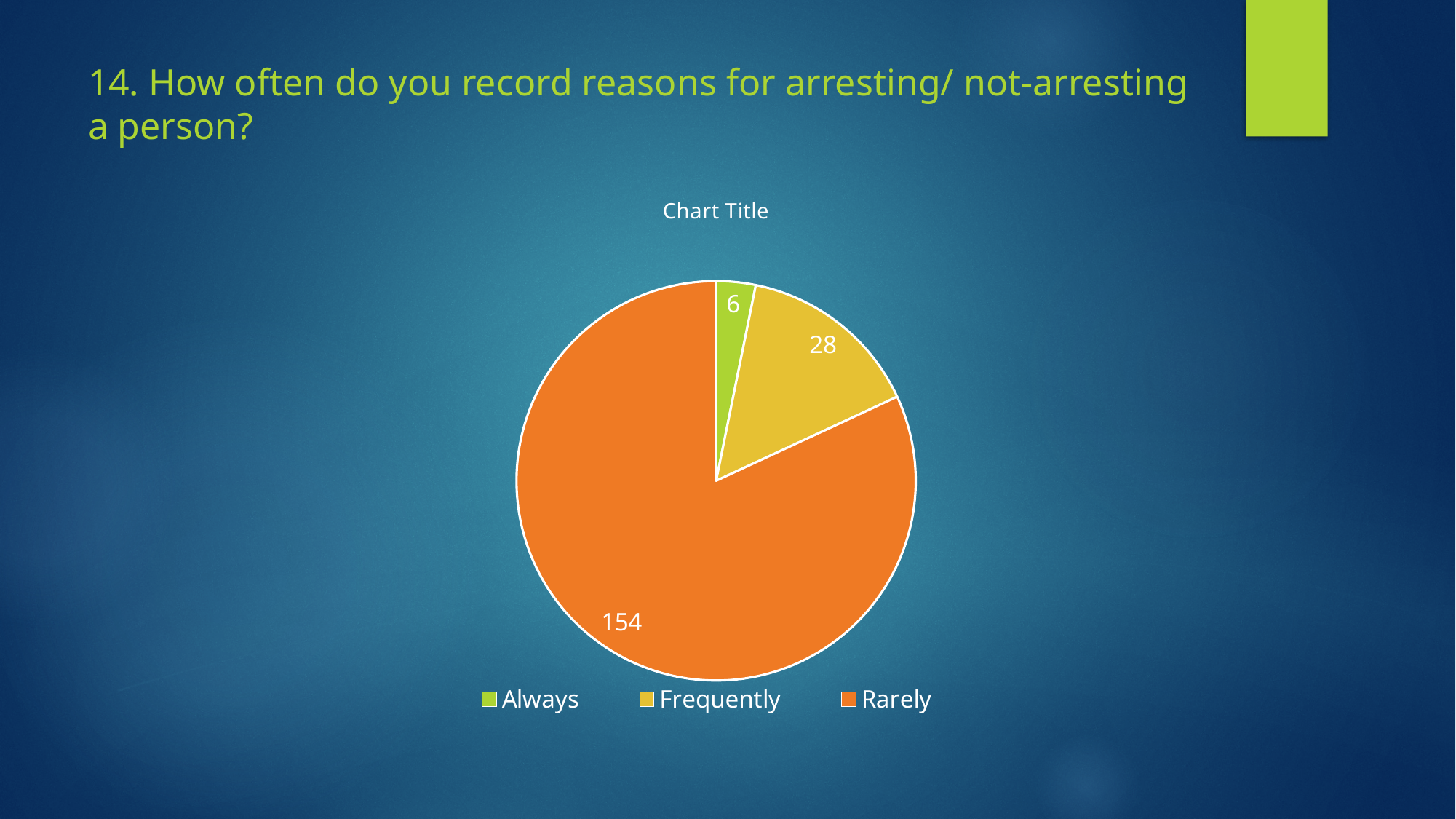
Which category has the smallest slice? Always What is the total of all slices in the pie chart? 188 Which is larger, the value for Frequently or the value for Always? Frequently What is the value for Always? 6 How many categories does the pie chart have? 3 What is the value for Frequently? 28 What is the difference between the values for Frequently and Always? 22 Which category has the largest slice? Rarely What is the title shown above the pie chart? Chart Title What is the value for Rarely? 154 What is the difference between the values for Rarely and Frequently? 126 What type of chart is shown on the slide? pie chart